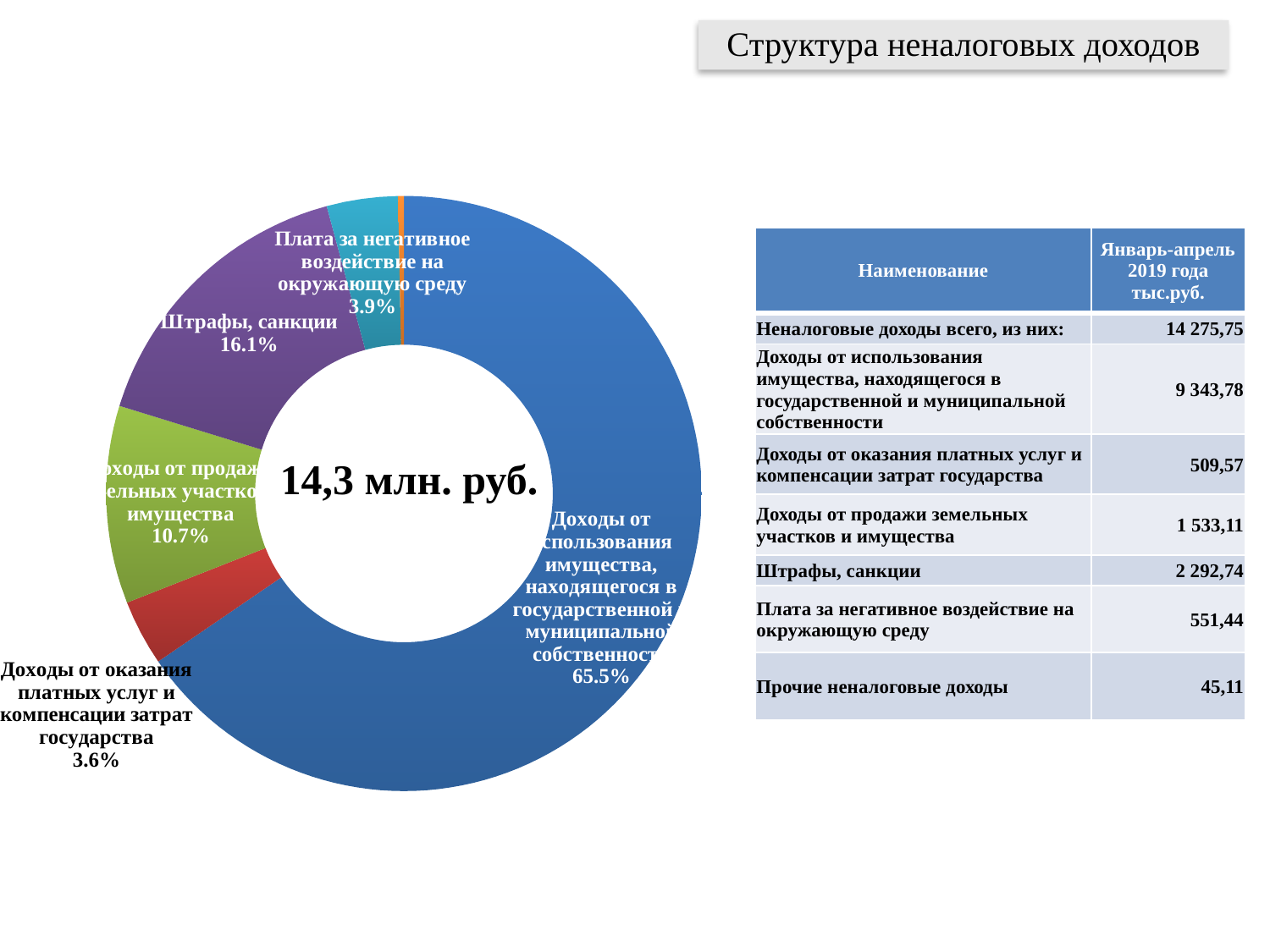
Which category has the largest slice in the doughnut chart? Доходы от использования имущества, находящегося в государственной и муниципальной собственности What percentage is shown for "Доходы от продажи земельных участков и имущества" in the chart? 10.7% What kind of chart is shown on the slide? doughnut chart What share of the doughnut chart is labelled for "Штрафы, санкции"? 16.1% What is the title shown at the top of the slide? Структура неналоговых доходов What percentage is shown for "Плата за негативное воздействие на окружающую среду" in the chart? 3.9% What is the difference in percentage points between the "Штрафы, санкции" slice and the "Доходы от продажи земельных участков и имущества" slice? 5.4 What total value is printed in the centre of the doughnut chart? 14,3 млн. руб. Which slice is larger: "Штрафы, санкции" or "Плата за негативное воздействие на окружающую среду"? Штрафы, санкции What percentage is shown for "Доходы от оказания платных услуг и компенсации затрат государства" in the chart? 3.6% How many slices in the doughnut chart have a percentage label? 5 Among the slices with percentage labels, which category has the smallest share? Доходы от оказания платных услуг и компенсации затрат государства